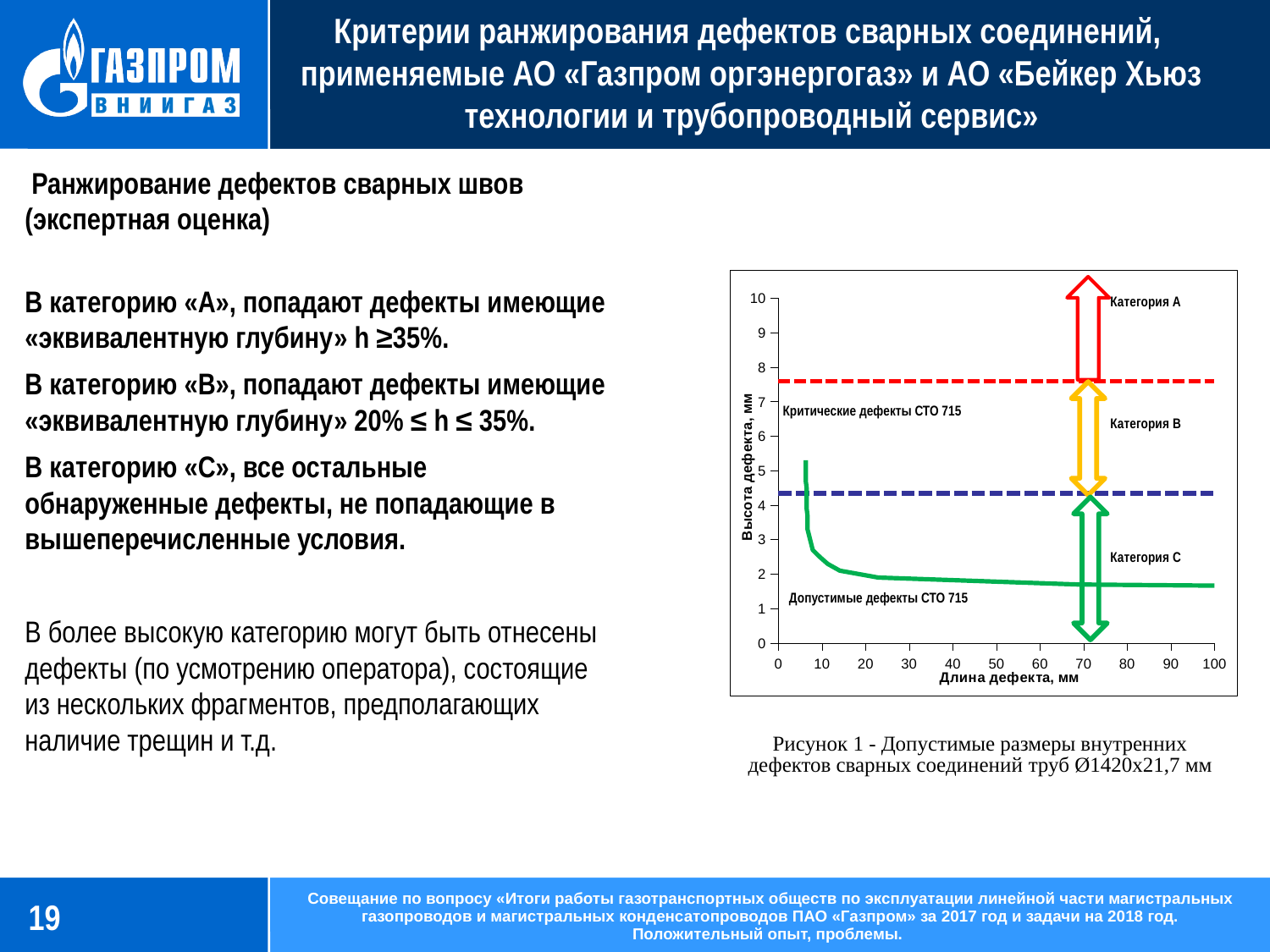
Is the height of the blue dashed line greater or less than 5 mm? less Is the height of the blue dashed line greater or less than 4 mm? greater What is the label of the vertical axis of the chart? Высота дефекта, мм Which dashed line lies higher on the chart, the red one or the blue one? the red one Is the height of the red dashed line greater or less than 8 mm? less Does the green curve rise or fall as the defect length increases along the x axis? fall What is the maximum value shown on the vertical axis of the chart? 10 What kind of chart is shown on the slide? line chart What is the label of the horizontal axis of the chart? Длина дефекта, мм